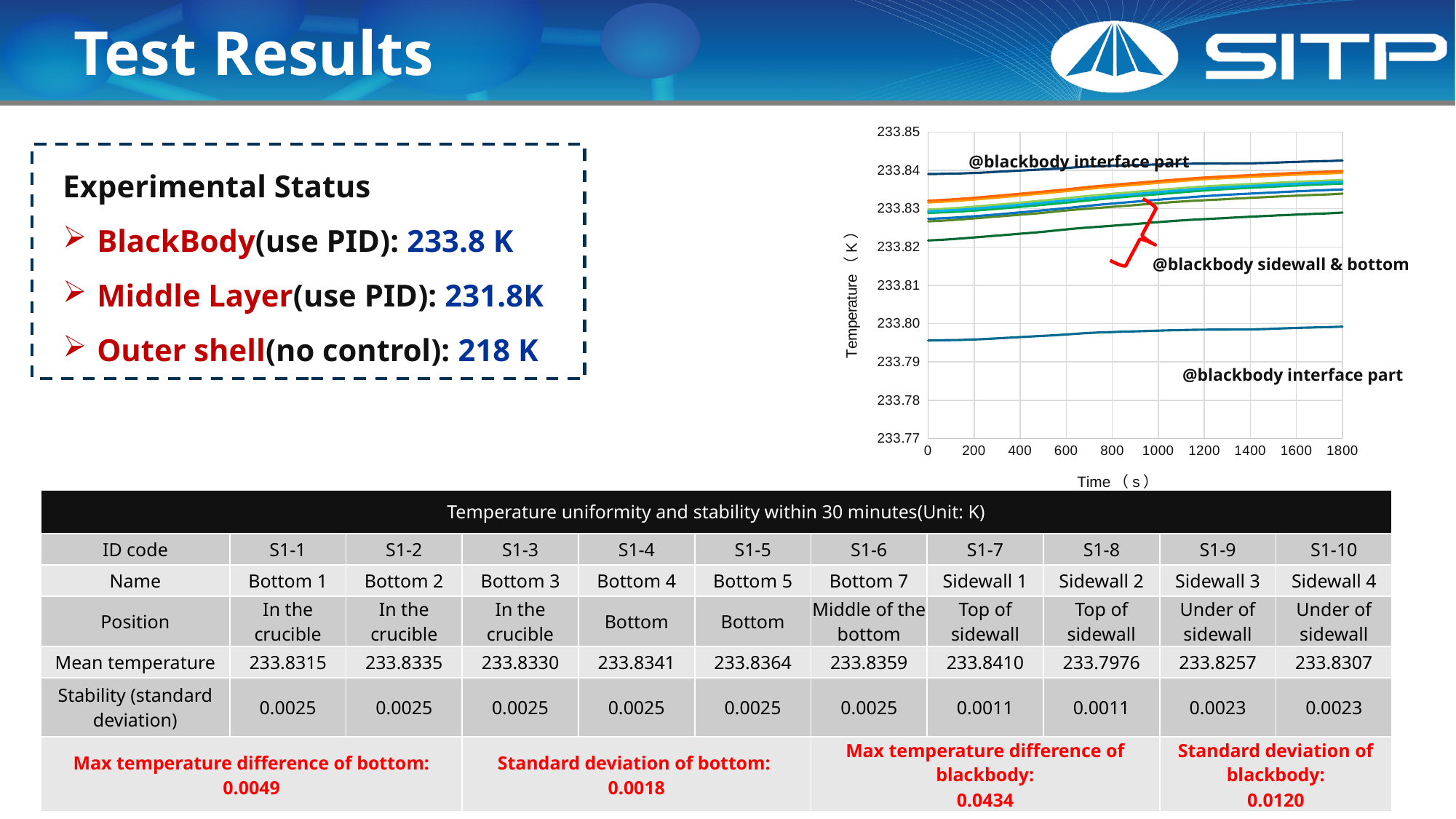
In the temperature chart, is the value of the lowest line at time 0 greater or less than 233.79? greater In the temperature chart, is the value of the topmost line at time 0 greater or less than 233.85? less In the temperature chart, is the value of the topmost line at time 1800 greater or less than 233.83? greater In the temperature chart, are the lines annotated "@blackbody sidewall & bottom" higher or lower than the lowest "@blackbody interface part" line? higher What kind of chart is shown on the right side of the slide? line chart What is the label of the vertical axis of the temperature chart? Temperature (K) What annotation text is placed next to the lowest line in the temperature chart? @blackbody interface part In the temperature chart, do the plotted lines generally rise or fall as time increases from 0 to 1800 s? rise